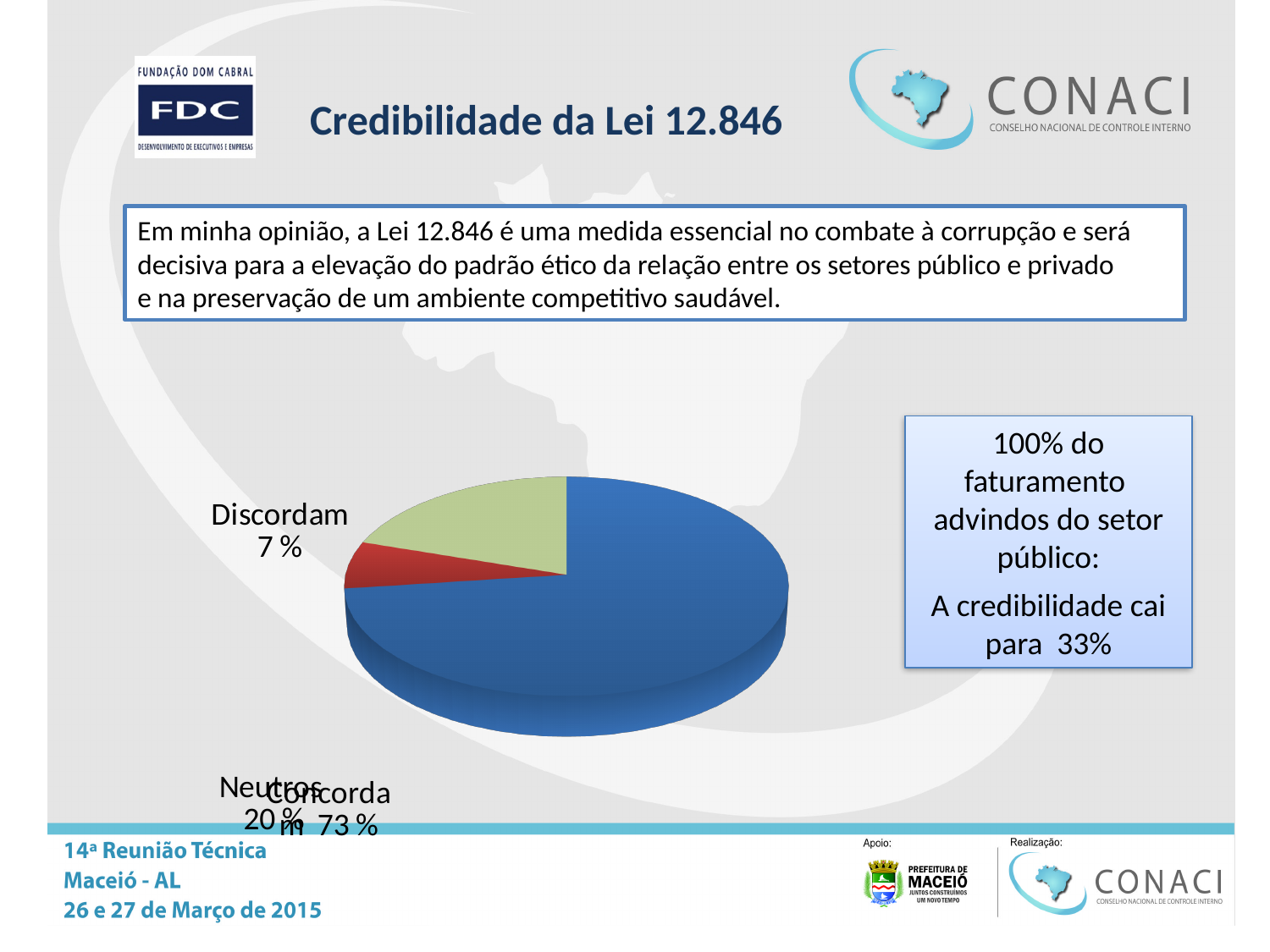
Which category has the smallest share of the pie? Discordam What colour is the Discordam slice of the pie? red What colour is the Concordam slice of the pie? blue What percentage of the pie is labelled Neutros? 20 % What is the difference in percentage points between Neutros and Discordam? 13 What is the difference in percentage points between Concordam and Neutros? 53 What percentage of the pie is labelled Concordam? 73 % Which is larger, the share for Neutros or the share for Discordam? Neutros What kind of chart is shown on the slide? pie chart What percentage of the pie is labelled Discordam? 7 % How many slices does the pie chart have? 3 Which category has the largest share of the pie? Concordam